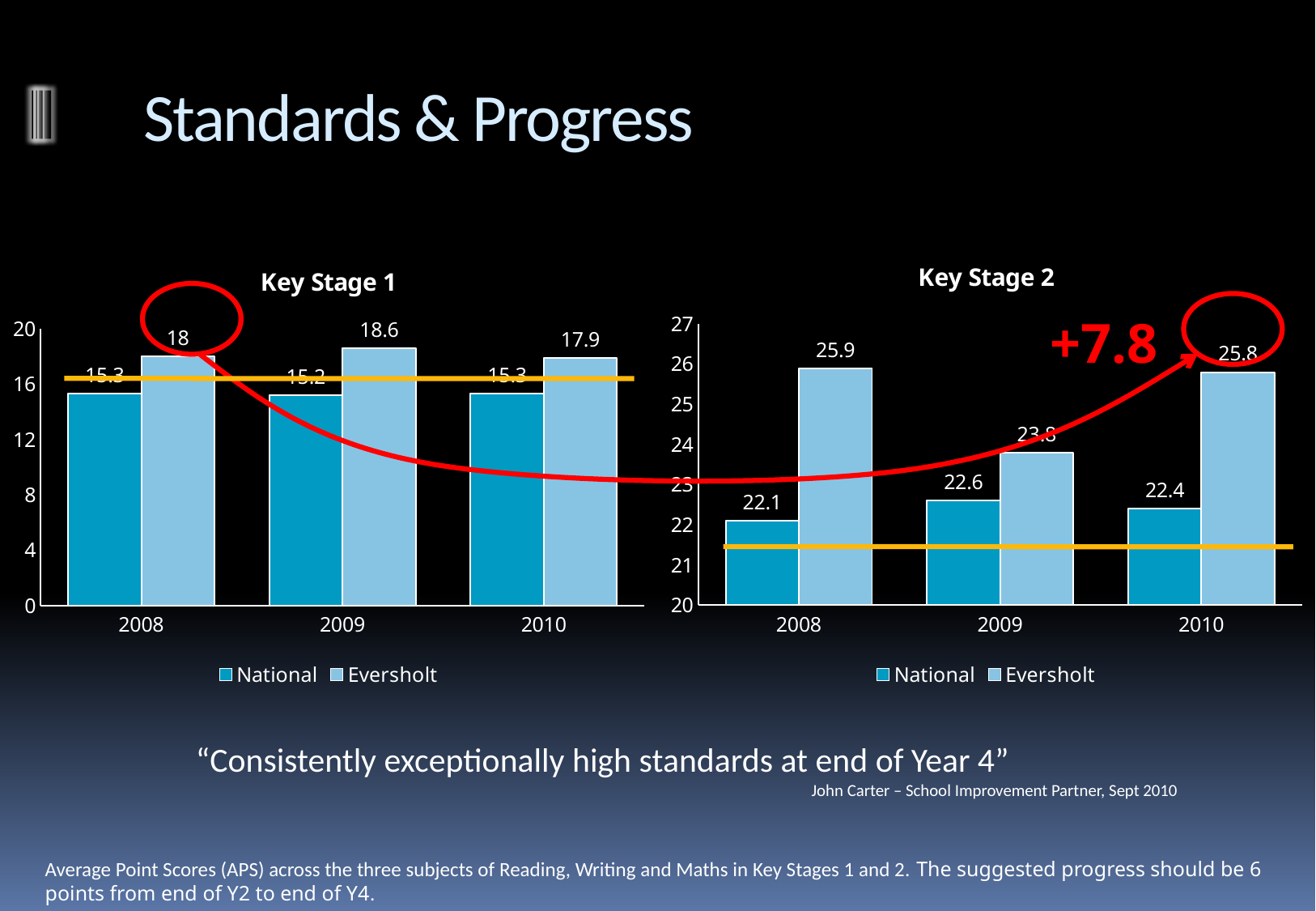
In the Key Stage 2 chart, what is the Eversholt value for 2010? 25.8 In the Key Stage 1 chart, what is the Eversholt value for 2009? 18.6 In the Key Stage 1 chart, which year has the highest Eversholt value? 2009 In the Key Stage 2 chart, what is the Eversholt value for 2008? 25.9 In the Key Stage 1 chart, what is the difference between the Eversholt values for 2009 and 2010? 0.7 In the Key Stage 2 chart, which is larger for 2010, National or Eversholt? Eversholt How many series does the legend of the Key Stage 1 chart list? 2 In the Key Stage 2 chart, what is the difference between the Eversholt and National values for 2008? 3.8 In the Key Stage 1 chart, what is the Eversholt value for 2008? 18 In the Key Stage 2 chart, which year has the lowest National value? 2008 In the Key Stage 2 chart, what is the National value for 2009? 22.6 In the Key Stage 2 chart, is the National value for 2010 greater or less than 23? less